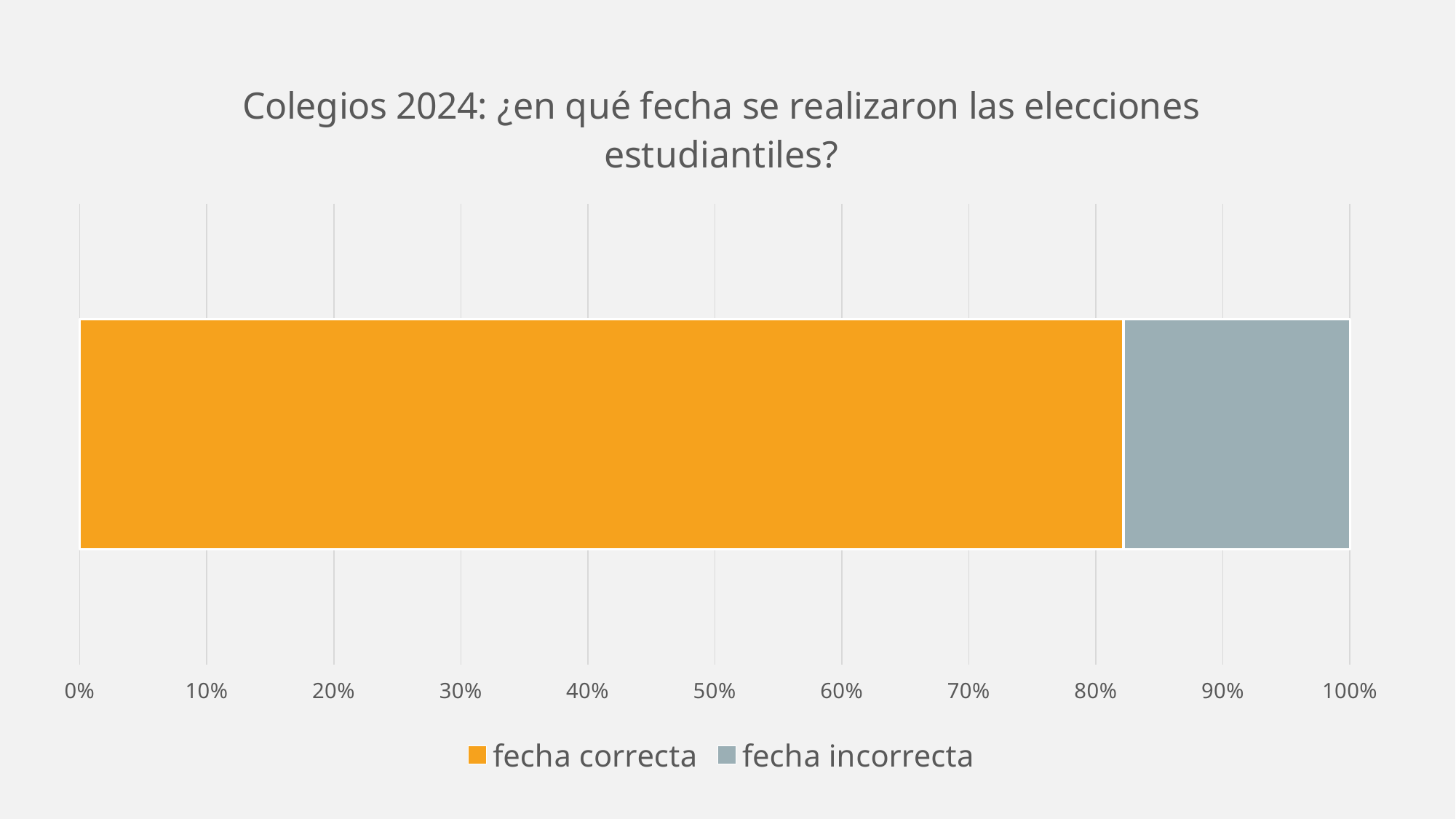
Which series has the highest value? fecha correcta What is the title of the chart? Colegios 2024: ¿en qué fecha se realizaron las elecciones estudiantiles? What are the two series named in the legend? fecha correcta, fecha incorrecta Which series has the lowest value? fecha incorrecta Is the value for fecha correcta greater or less than 90%? less Is the value for fecha correcta greater or less than 70%? greater What kind of chart is shown on the slide? bar chart Which series takes up the larger share of the bar, fecha correcta or fecha incorrecta? fecha correcta What is the total of the stacked bar? 100% How many series does the legend list? 2 Is the value for fecha incorrecta greater or less than 30%? less How many bars are plotted in the chart? 1